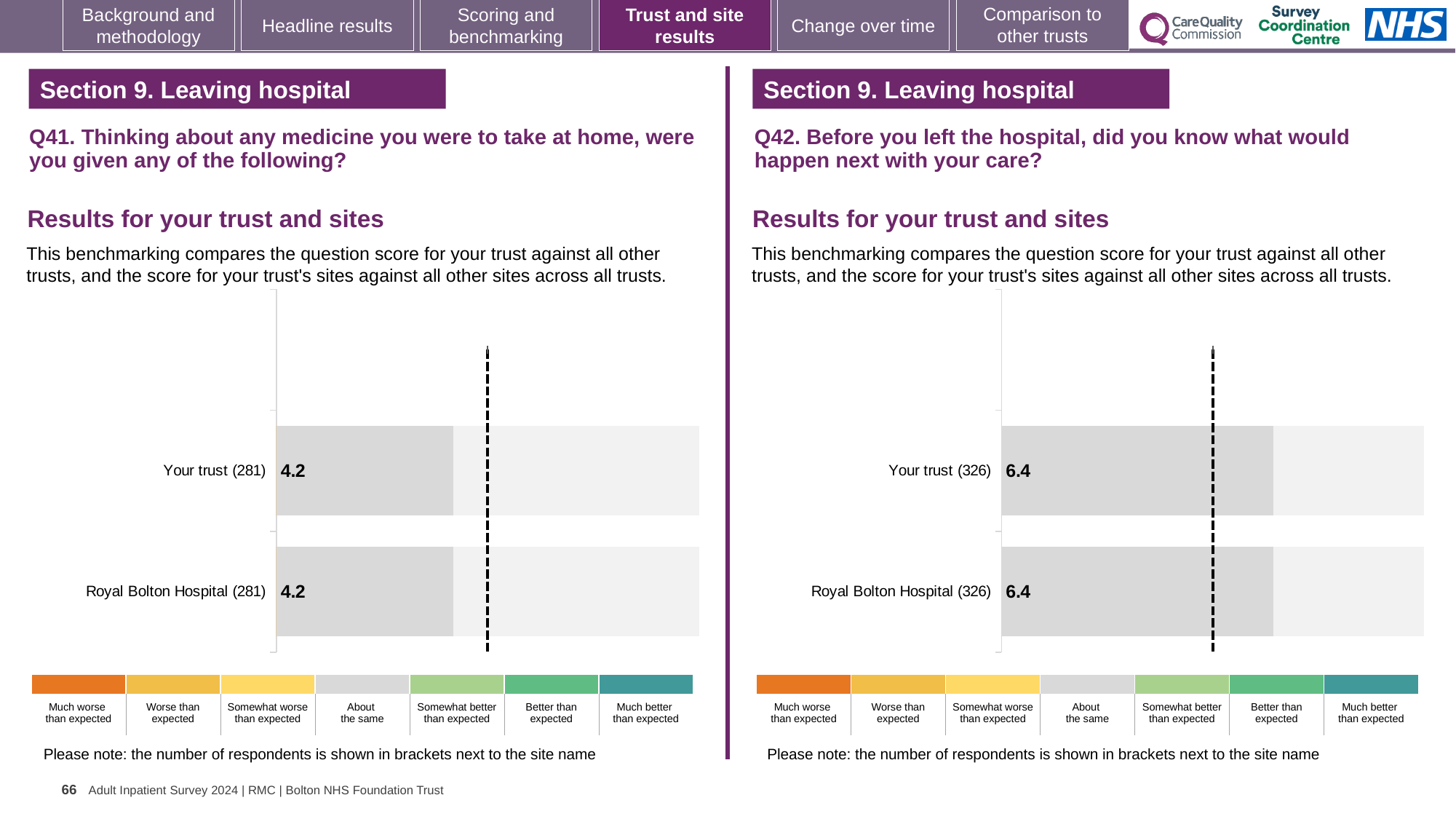
What kind of chart is the Q42 chart on the right? Bar chart In the Q41 chart on the left, how many respondents are shown in brackets next to Royal Bolton Hospital? 281 In the Q42 chart on the right, what is the score for Royal Bolton Hospital? 6.4 In the Q41 chart on the left, what is the score for Your trust? 4.2 How many bars are plotted in the Q42 chart on the right? 2 In the Q42 chart on the right, how many respondents are shown in brackets next to Your trust? 326 In the Q42 chart on the right, what is the score for Your trust? 6.4 In the Q42 chart on the right, what is the difference between the score for Your trust and the score for Royal Bolton Hospital? 0 In the Q41 chart on the left, what is the score for Royal Bolton Hospital? 4.2 How many bars are plotted in the Q41 chart on the left? 2 In the Q41 chart on the left, which benchmark category does the grey colour of the bars correspond to in the legend? About the same In the Q41 chart on the left, what is the difference between the score for Your trust and the score for Royal Bolton Hospital? 0